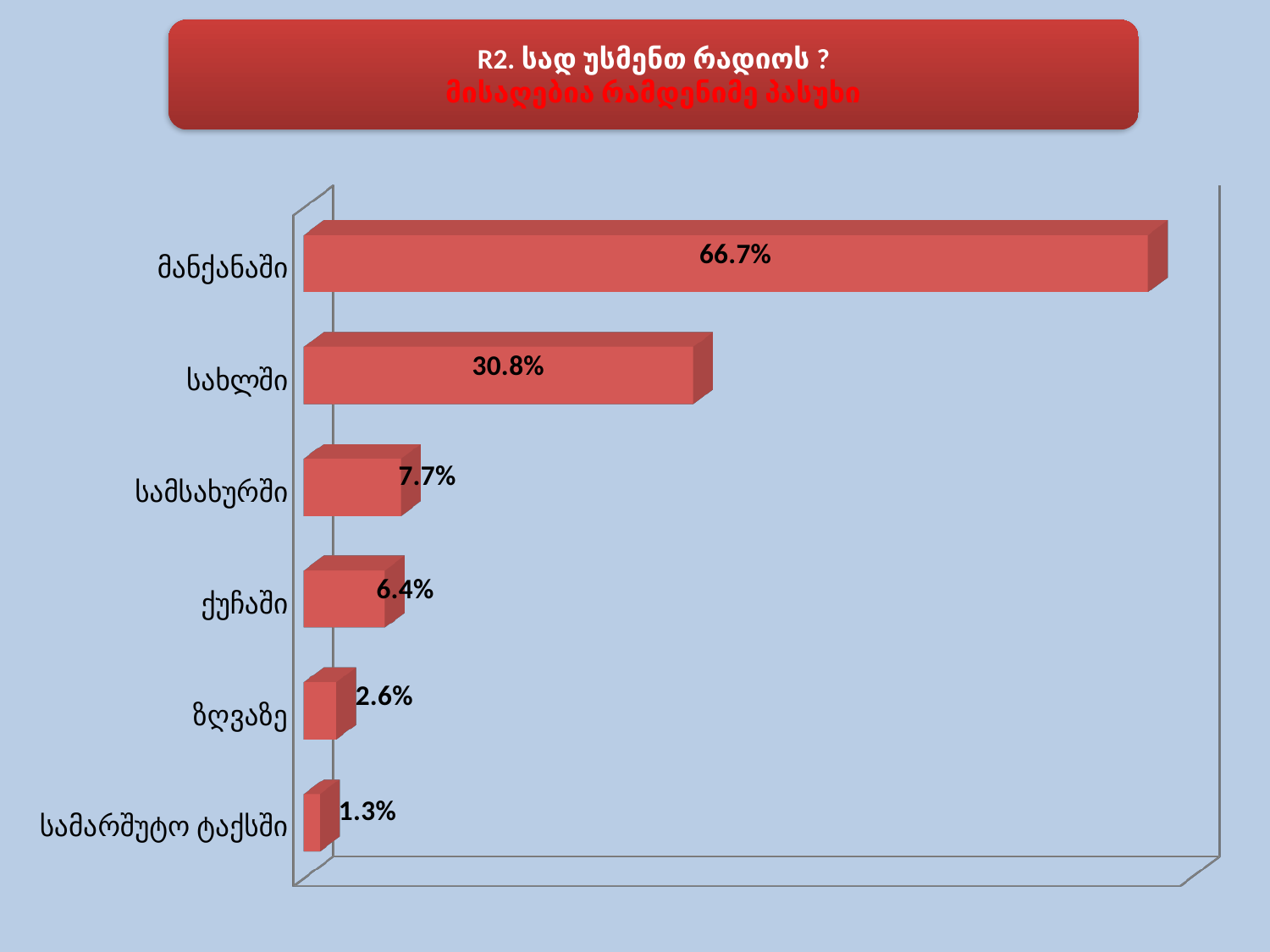
How many categories are shown in the chart? 6 What is the difference between the values for მანქანაში and სახლში? 35.9% Which is larger, the value for ქუჩაში or the value for ზღვაზე? ქუჩაში What value is shown for სამსახურში? 7.7% What kind of chart is shown on the slide? Bar chart What value is shown for ზღვაზე? 2.6% Which category has the highest value? მანქანაში Which category has the lowest value? სამარშუტო ტაქსში What value is shown for მანქანაში? 66.7% What is the question number shown in the title of the slide? R2 What value is shown for სახლში? 30.8% What is the difference between the values for სამსახურში and ქუჩაში? 1.3%